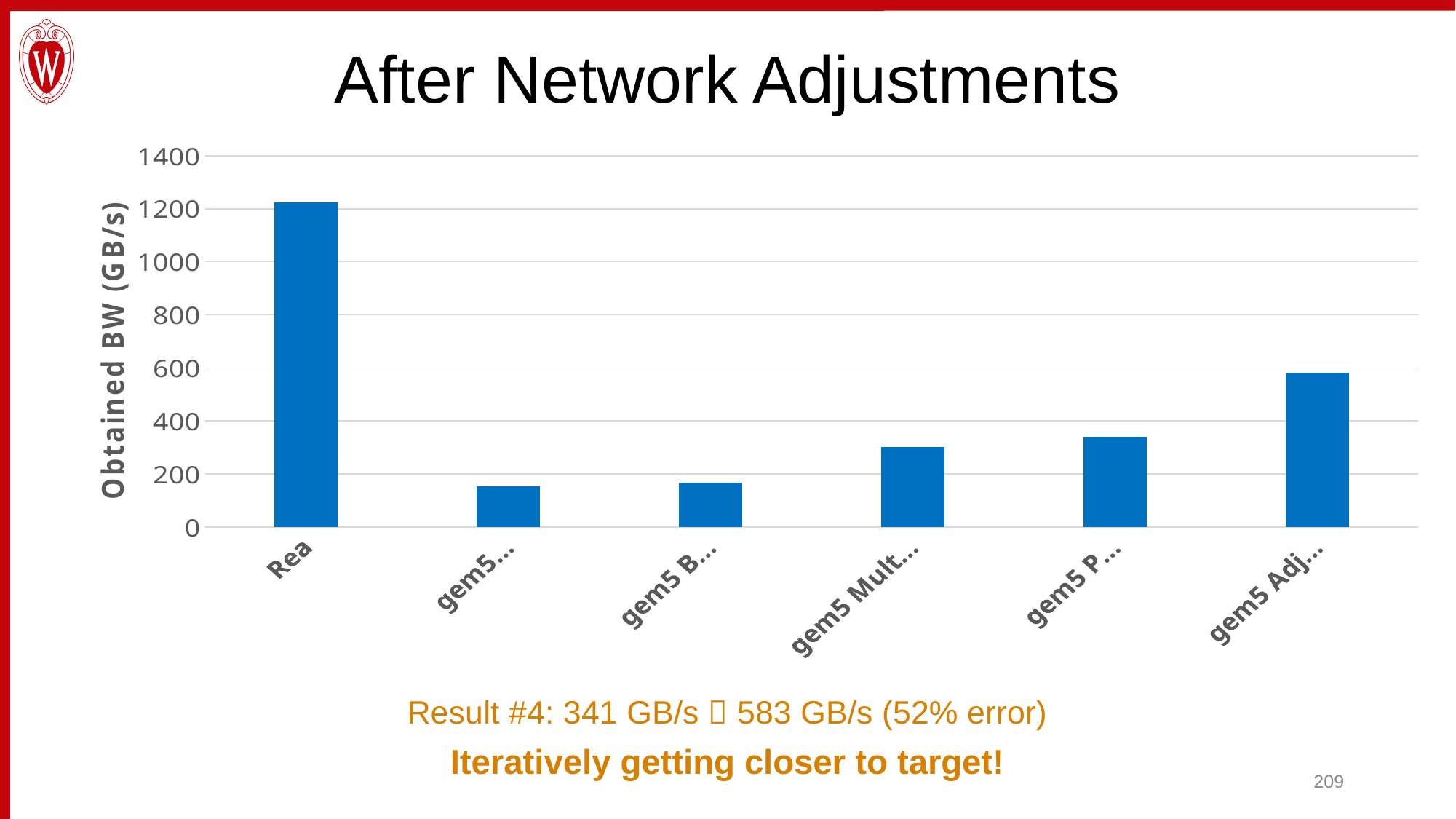
Which is larger, the value for the first bar (Rea) or the last bar (gem5 Adj...)? Rea Which is larger, the value for the fourth bar (gem5 Mult...) or the last bar (gem5 Adj...)? gem5 Adj... Is the value for the first bar (Rea) greater or less than 1000? greater What kind of chart is shown on the slide? bar chart Which category has the highest Obtained BW? Rea (the first bar) Do the values rise or fall across the last four bars, from gem5 B... to gem5 Adj...? rise Is the value for the fourth bar (gem5 Mult...) greater or less than 400? less Is the value for the last bar (gem5 Adj...) greater or less than 400? greater What is the label on the vertical axis of the chart? Obtained BW (GB/s) How many bars are plotted in the chart? 6